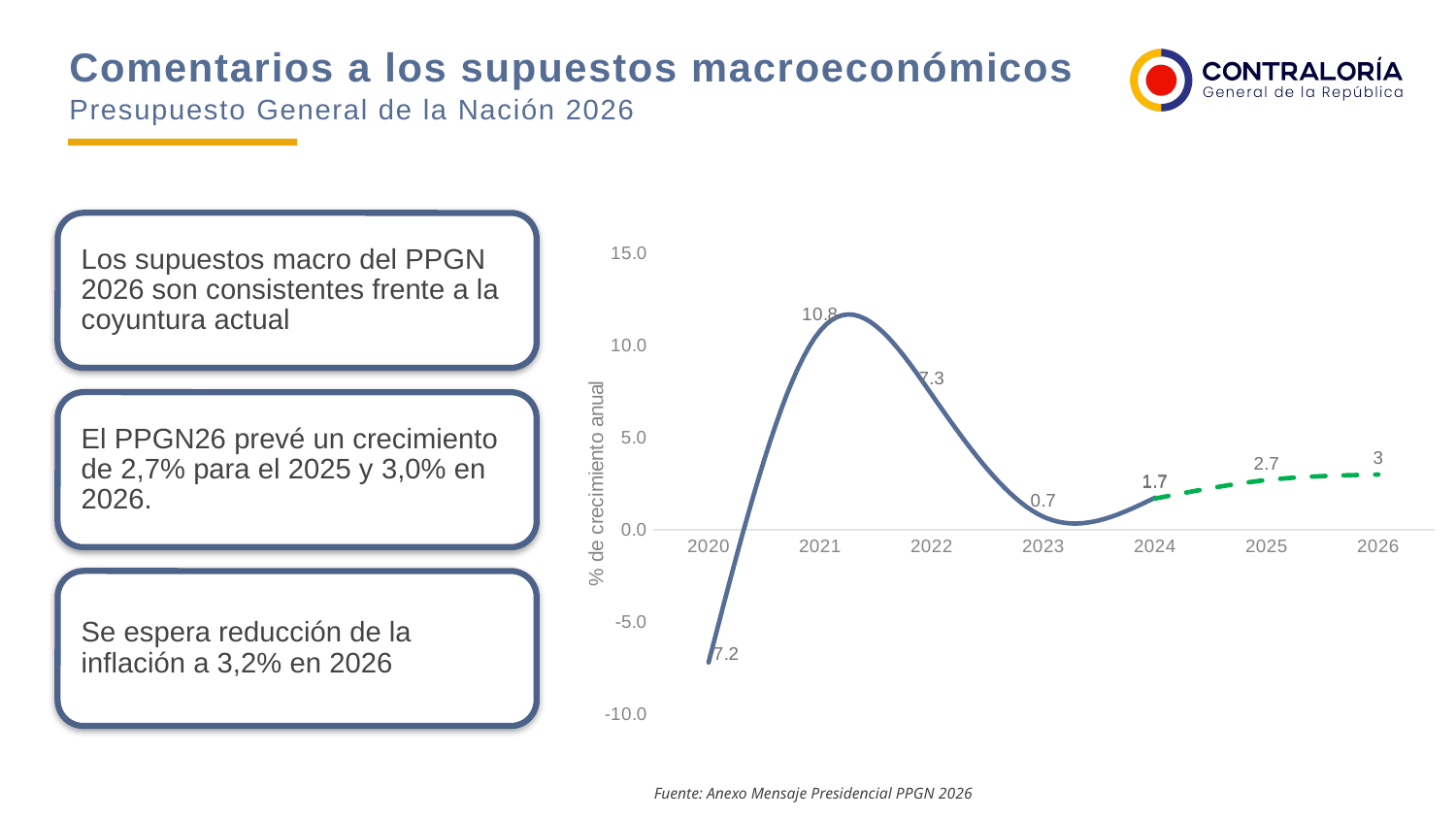
What is the value for 2026 in the chart? 3 What is the difference between the values for 2021 and 2022? 3.5 What is the label on the vertical axis of the chart? % de crecimiento anual What is the value for 2024 in the chart? 1.7 What is the value for 2025 in the chart? 2.7 What is the value for 2022 in the chart? 7.3 Which year has the lowest value in the chart? 2020 What is the value for 2023 in the chart? 0.7 Which year has the highest value in the chart? 2021 Is the value for 2020 greater or less than 0.0? less What type of chart is shown on the slide? line chart What is the value for 2021 in the chart? 10.8